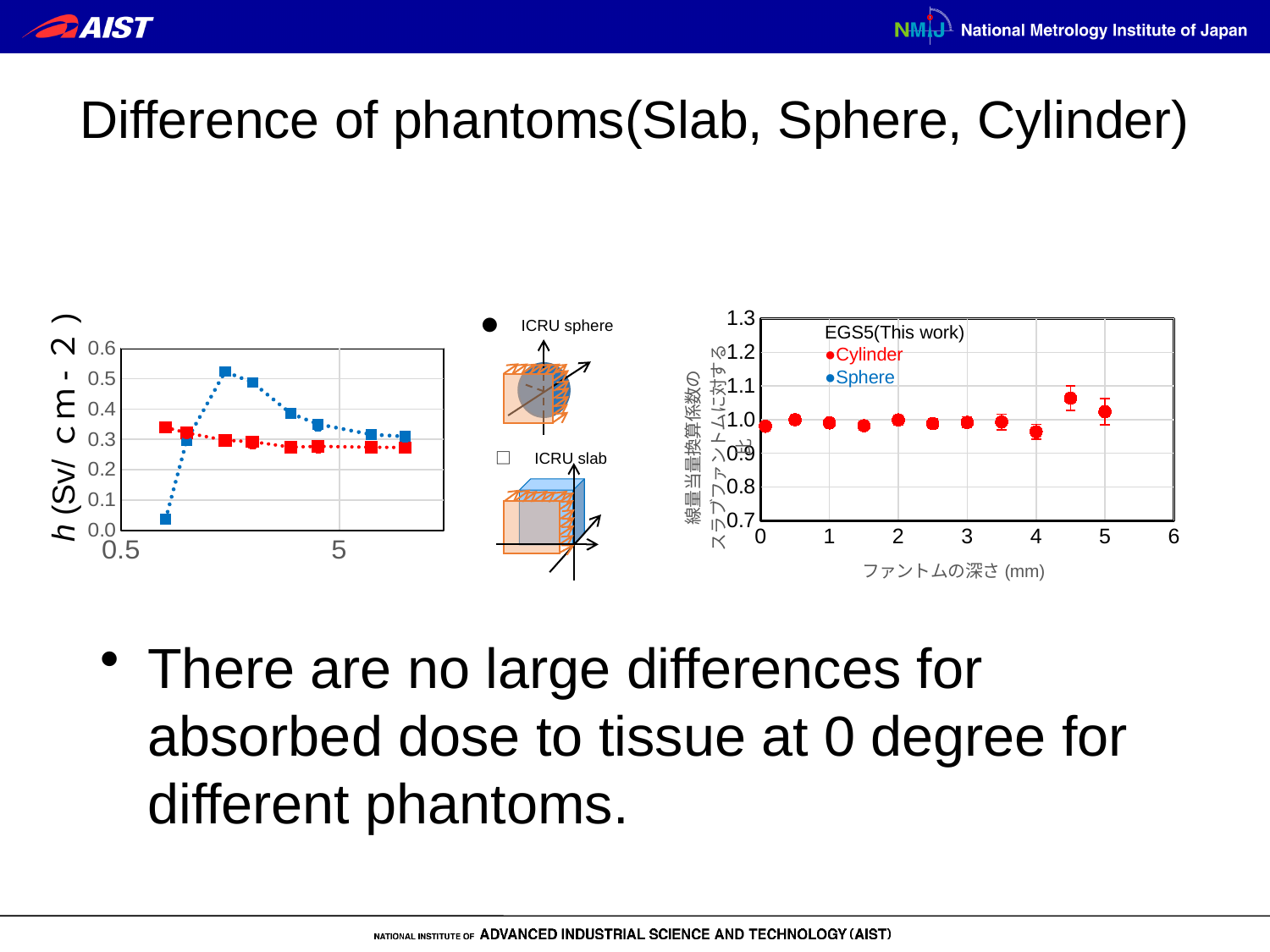
In the right chart, is the value at a depth of 2 mm greater or less than 1.1? less In the left chart, is the value of the blue series at its leftmost point greater or less than 0.1? less In the right chart, what colour are the Cylinder data points? red What kind of chart is the left chart with the blue and red square markers? scatter (line) chart In the left chart, does the red series rise or fall as x increases? fall In the right chart, is the value at a depth of 4.5 mm greater or less than 1.0? greater In the right chart, at which depth (mm) is the plotted value highest? 4.5 In the left chart, at the leftmost x position, which series has the larger value, the blue or the red? red In the right chart, which two series does the legend list under EGS5(This work)? Cylinder and Sphere What kind of chart is the right chart labelled EGS5(This work)? scatter chart